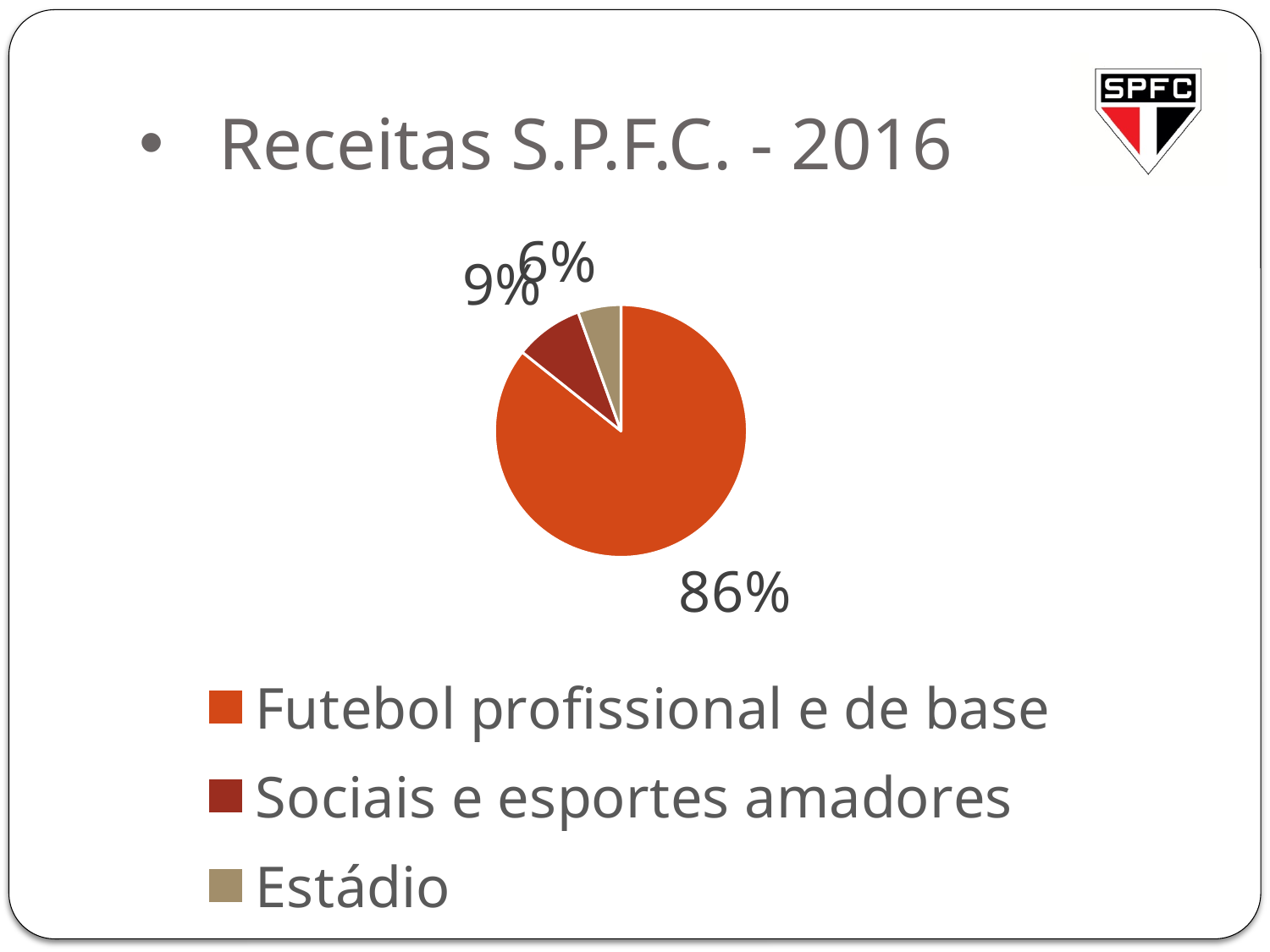
Which category has the smallest slice of the pie? Estádio What is the difference in percentage points between Futebol profissional e de base and Sociais e esportes amadores? 77 What is the title of the chart on the slide? Receitas S.P.F.C. - 2016 What share of the pie does Estádio represent? 6% What is the difference in percentage points between Sociais e esportes amadores and Estádio? 3 What share of the pie does Sociais e esportes amadores represent? 9% How many categories does the pie chart show? 3 Which category has the largest slice of the pie? Futebol profissional e de base Which is larger, the slice for Sociais e esportes amadores or the slice for Estádio? Sociais e esportes amadores What kind of chart is shown on the slide? pie chart Which category is shown in the tan/beige colour in the legend? Estádio What share of the pie does Futebol profissional e de base represent? 86%